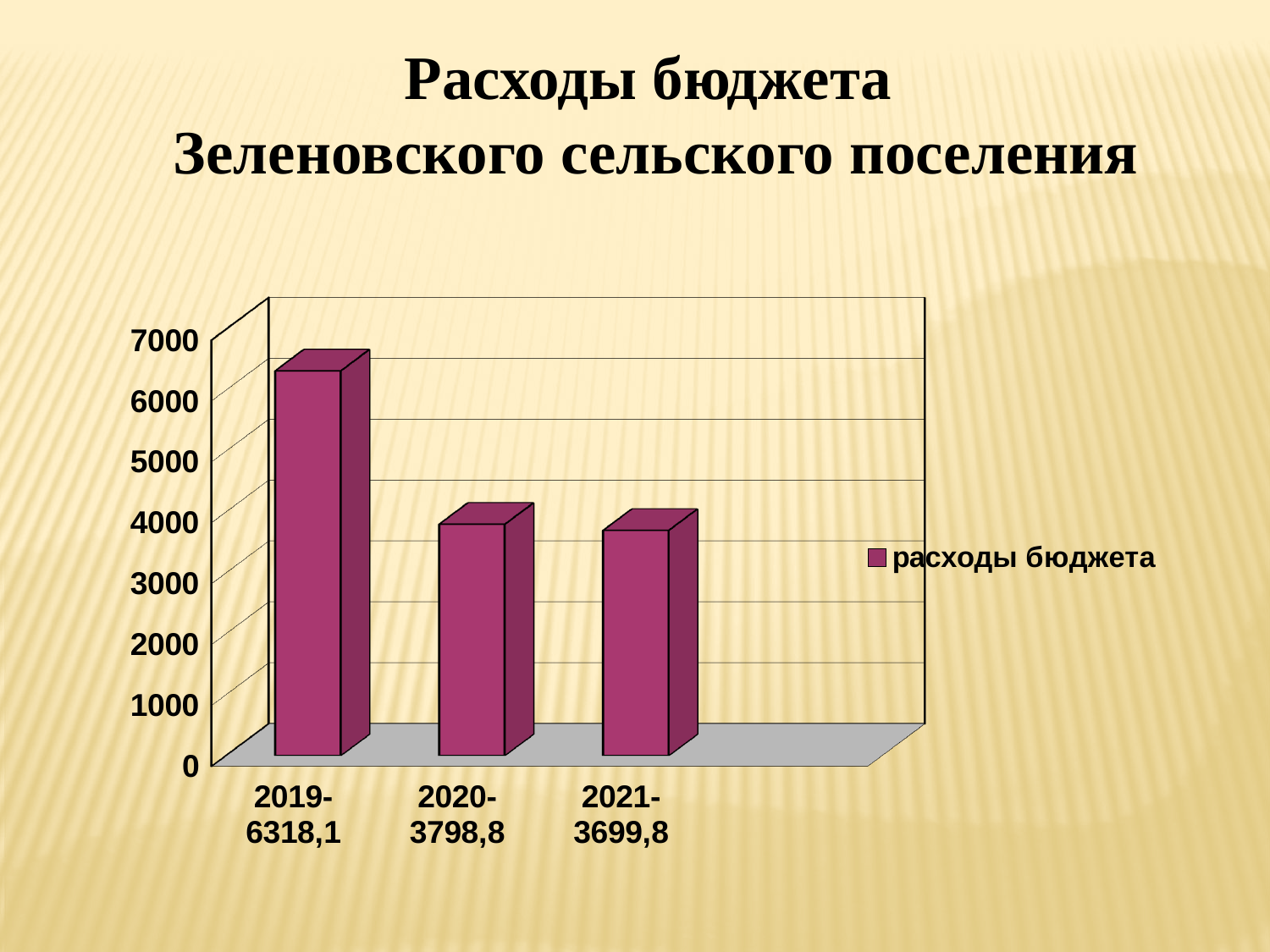
How many years are shown on the chart? 3 What is the difference between the budget expenditure for 2019 and 2020? 2519,3 What kind of chart is shown on the slide? bar chart Is the value for 2019 greater or less than 6000? greater What is the budget expenditure value shown for 2021? 3699,8 Which year has the highest budget expenditure? 2019 What is the budget expenditure value shown for 2020? 3798,8 What is the difference between the budget expenditure for 2020 and 2021? 99,0 What is the budget expenditure value shown for 2019? 6318,1 Do the budget expenditure values rise or fall from 2019 to 2021? fall Which year has the lowest budget expenditure? 2021 Which is larger, the budget expenditure for 2020 or for 2021? 2020